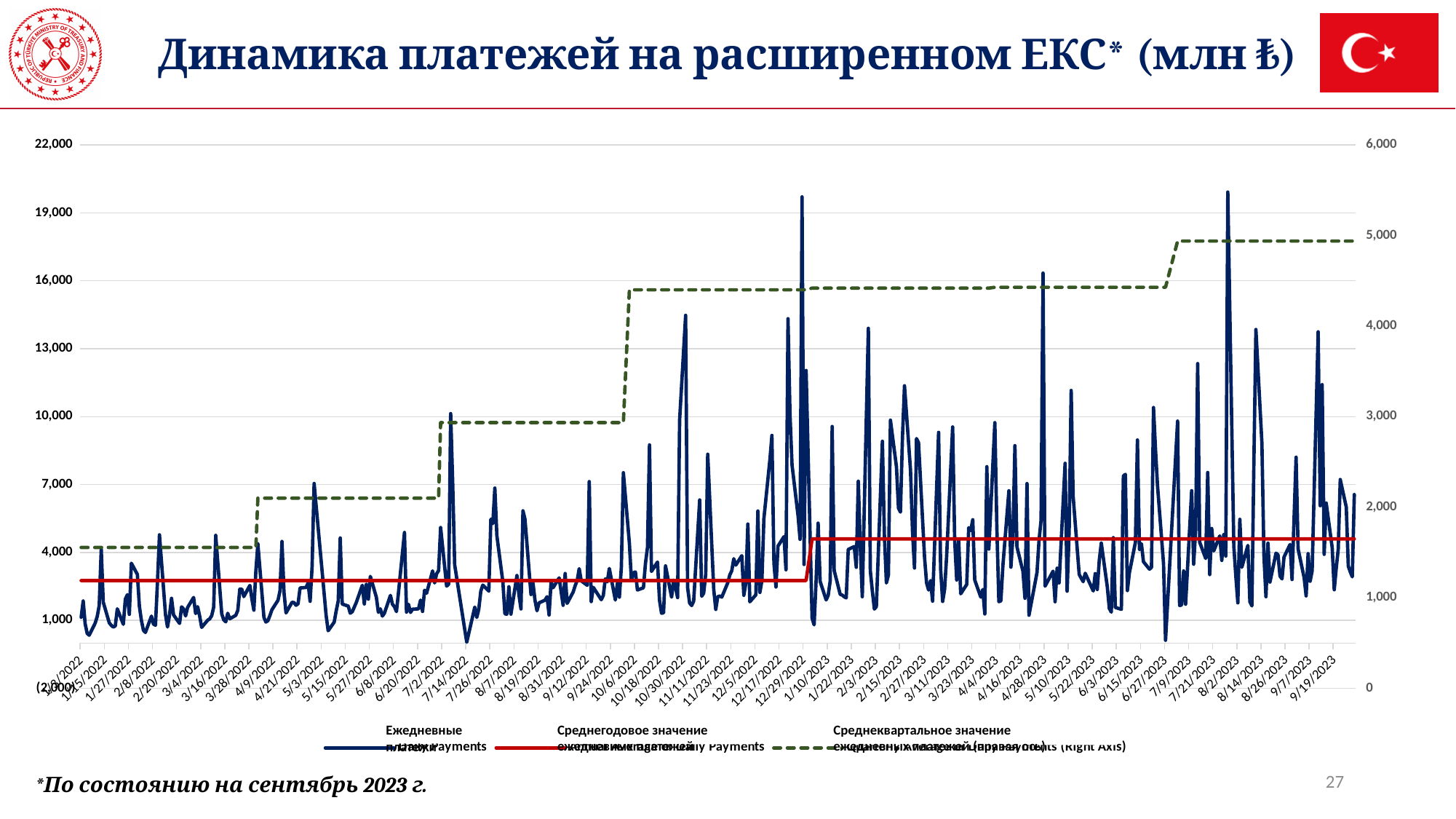
What is the title of the chart? Динамика платежей на расширенном ЕКС* (млн ₺) Which is larger: the quarterly average of daily payments in the last quarter shown (from 7/2023) or in the first quarter of 2022? the last quarter shown (from 7/2023) On the right axis, is the quarterly average of daily payments in the first quarter of 2022 greater or less than 2,000? less Is the annual average of daily payments (red line) for 2022 greater or less than 4,000? less Is the highest peak of daily payments, near 8/2/2023, greater or less than 19,000? greater How many series does the legend list? 3 Does the quarterly average of daily payments (green dashed line) rise or fall from left to right? rise What kind of chart is shown on the slide? line chart Which is larger: the annual average of daily payments in 2023 or in 2022? 2023 Which series is plotted against the right axis? Среднеквартальное значение ежедневных платежей